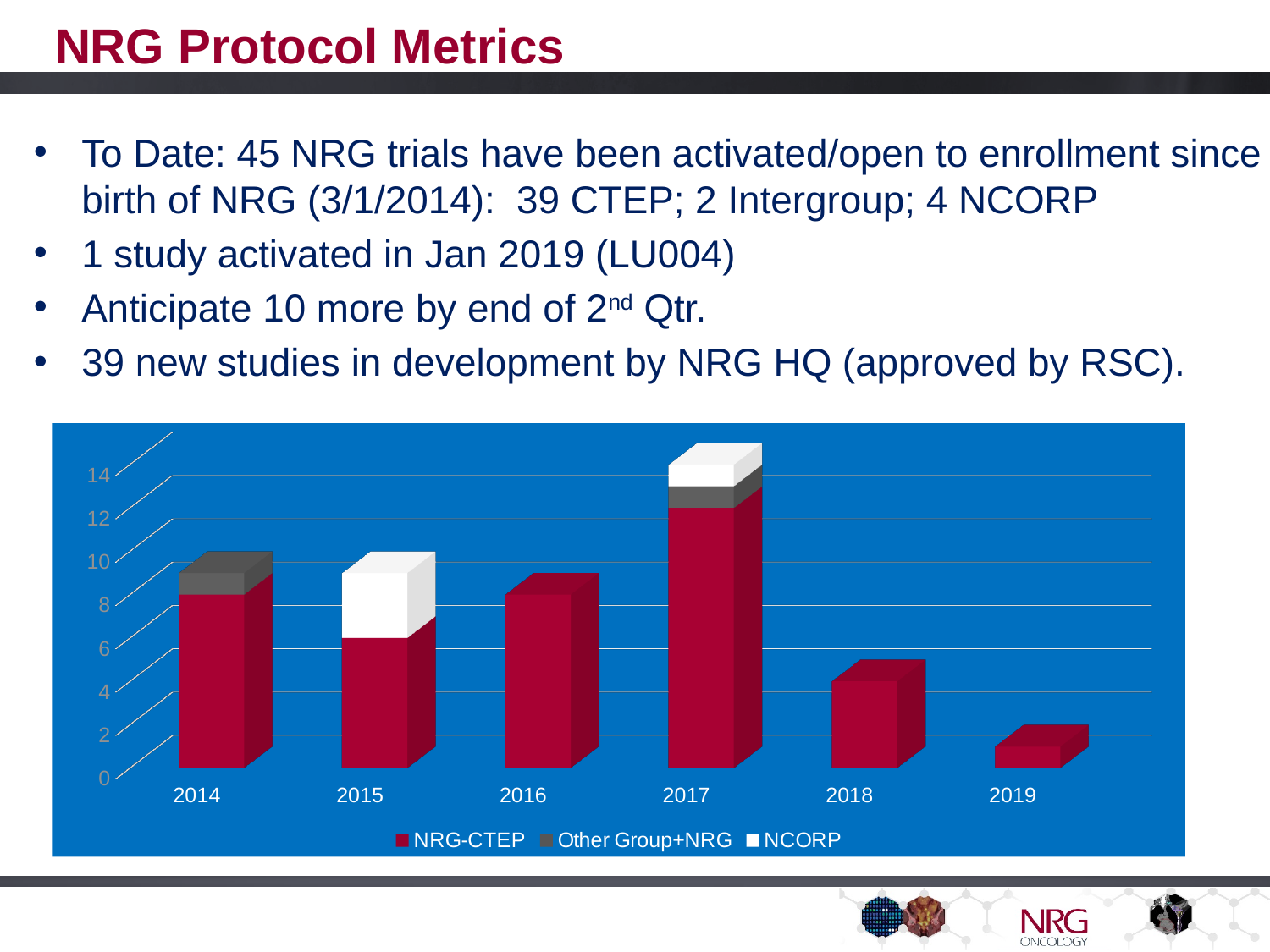
Which year has the shortest stacked bar in the chart? 2019 How many years are shown on the x axis of the chart? 6 Is the total stacked bar for 2017 greater or less than 12? greater Which series is shown in white in the chart legend? NCORP Which year has the larger stacked bar, 2017 or 2018? 2017 Is the NRG-CTEP value for 2016 greater or less than 6? greater Do the stacked bar totals rise or fall from 2017 to 2019? fall Is the value for 2018 greater or less than 6? less How many series does the chart legend list? 3 What kind of chart is shown on the slide? bar chart Which year has the tallest stacked bar in the chart? 2017